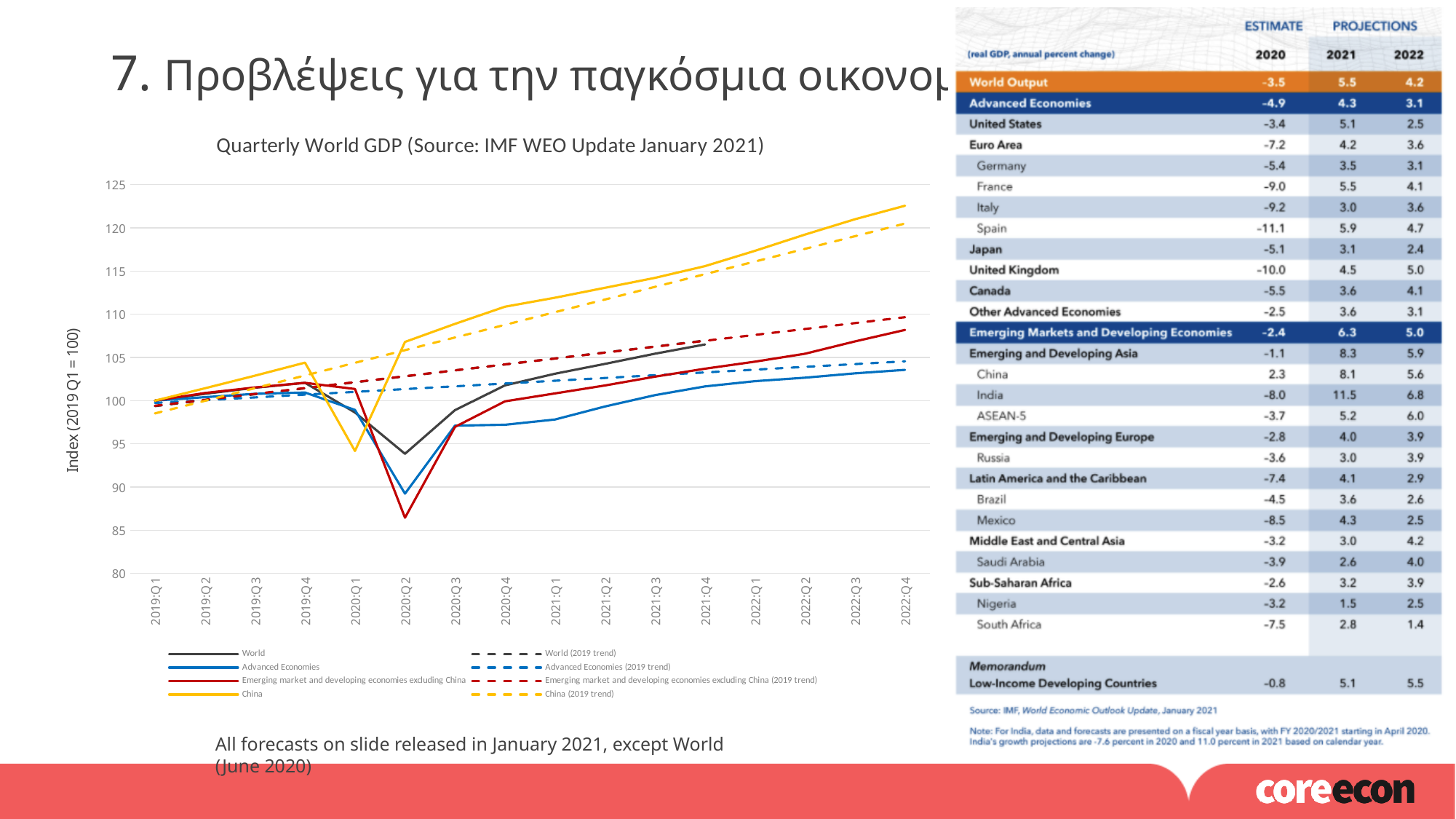
In the 'Quarterly World GDP' chart, what colour is the China line? yellow How many series does the legend of the 'Quarterly World GDP' chart list? 8 In the 'Quarterly World GDP' chart, is the value for China in 2022:Q4 greater or less than 120? greater What is the y-axis label of the 'Quarterly World GDP' chart? Index (2019 Q1 = 100) In the 'Quarterly World GDP' chart, which is higher in 2020:Q2, World or Advanced Economies? World In the 'Quarterly World GDP' chart, is the value for World in 2020:Q2 greater or less than 90? greater In the 'Quarterly World GDP' chart, which series has the lowest value in 2020:Q2? Emerging market and developing economies excluding China How many quarters are shown on the x axis of the 'Quarterly World GDP' chart? 16 In the 'Quarterly World GDP' chart, which series has the highest value in 2022:Q4? China What kind of chart is the 'Quarterly World GDP' chart? line chart In the 'Quarterly World GDP' chart, does the China line rise or fall from 2020:Q2 to 2022:Q4? rise In the 'Quarterly World GDP' chart, is the value for Emerging market and developing economies excluding China in 2020:Q2 greater or less than 90? less